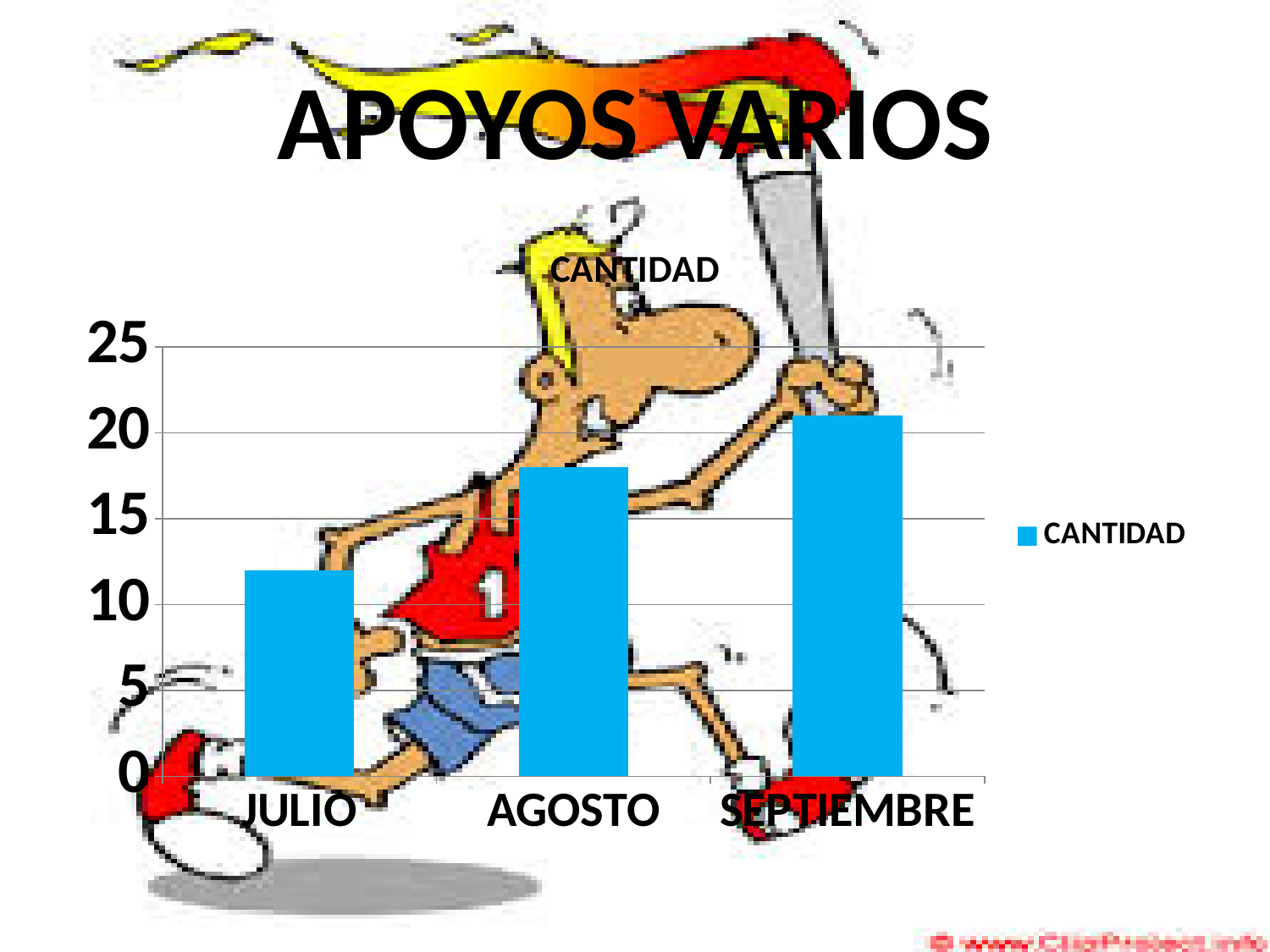
Is the value for AGOSTO greater or less than 20? less Which month has the lowest value in the chart? JULIO Do the values rise or fall from JULIO to SEPTIEMBRE? rise What is the title of the chart? CANTIDAD How many categories are shown on the x axis of the chart? 3 How many series does the chart's legend list? 1 Is the value for SEPTIEMBRE greater or less than 20? greater Which has a larger value, AGOSTO or JULIO? AGOSTO Is the value for JULIO greater or less than 10? greater What kind of chart is shown on the slide? bar chart Which month has the highest value in the chart? SEPTIEMBRE What is the name of the series listed in the chart's legend? CANTIDAD